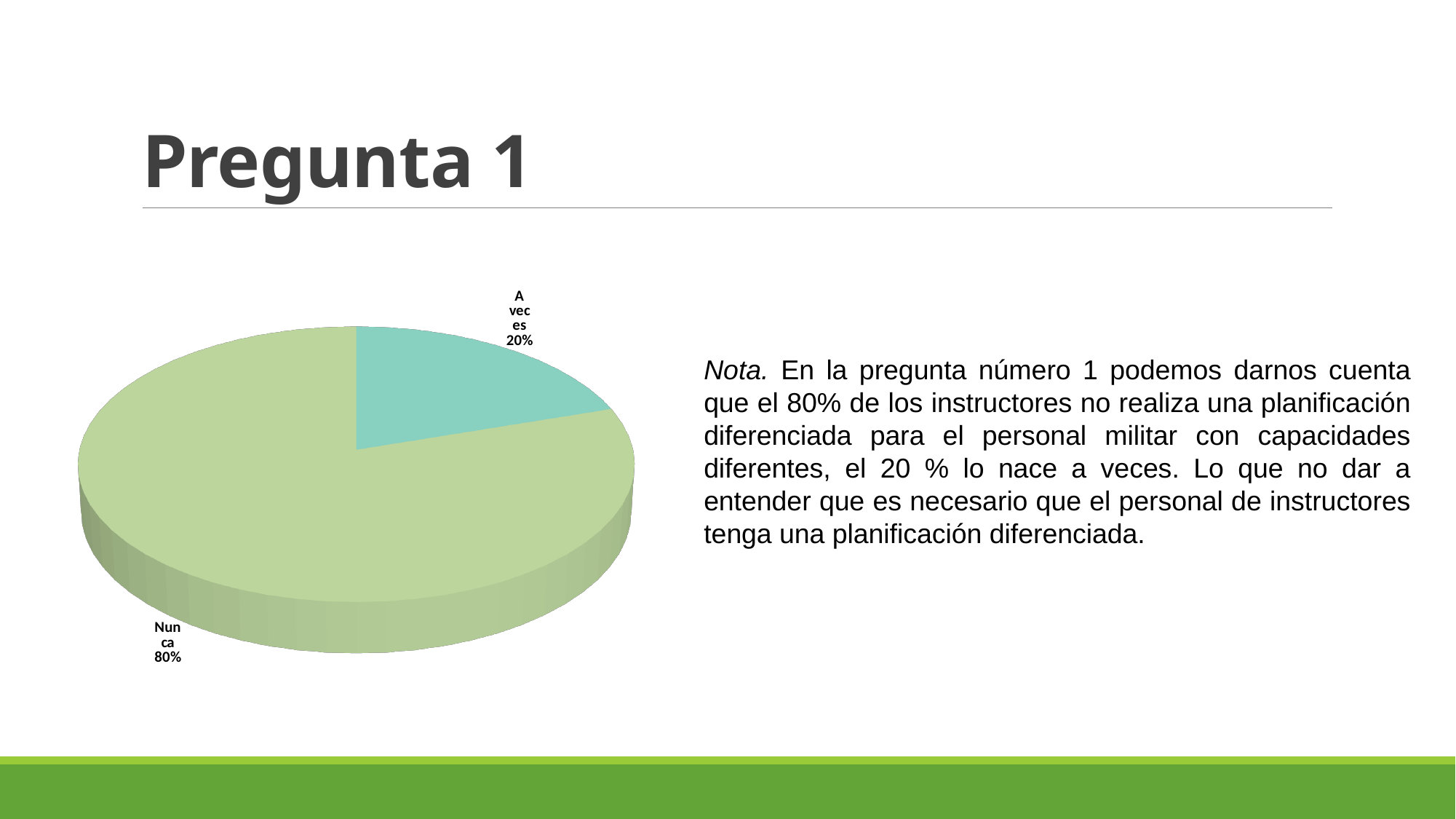
What share of the pie does the "Nunca" slice represent? 80% Which category has the largest slice of the pie? Nunca Which category has the smallest slice of the pie? A veces What is the title of the slide containing the chart? Pregunta 1 What share of the pie does the "A veces" slice represent? 20% How many slices does the pie chart have? 2 What is the difference in percentage points between the "Nunca" and "A veces" slices? 60% What kind of chart is shown on the slide? Pie chart What colour is the "A veces" slice of the pie? Teal (blue-green) Which slice is larger, "Nunca" or "A veces"? Nunca